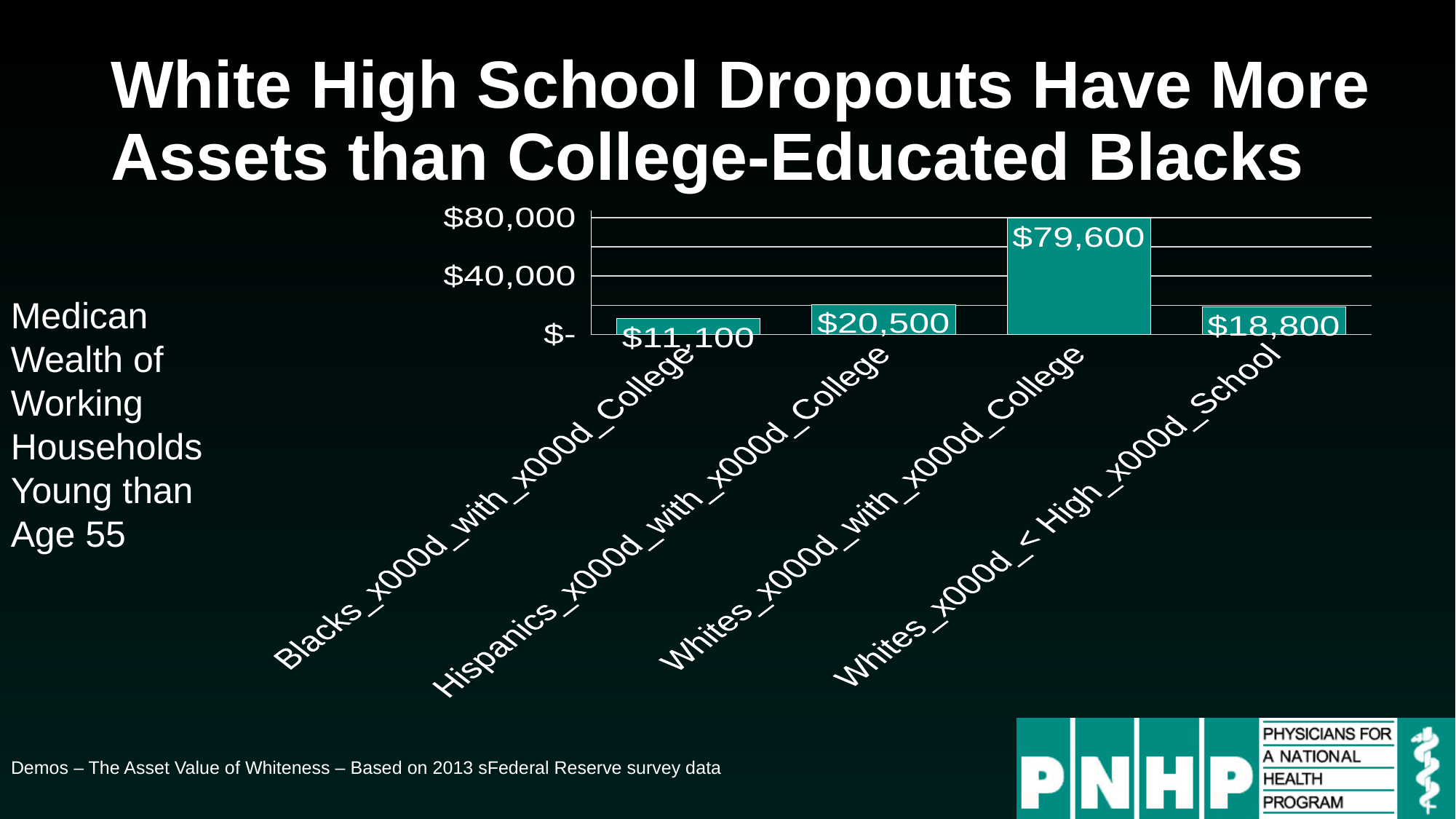
What is the difference between the median wealth of Whites with College and Blacks with College? $68,500 What is the median wealth value shown for Blacks with College? $11,100 What is the median wealth value shown for Whites with College? $79,600 How many categories are shown in the chart? 4 What is the difference between the median wealth of Hispanics with College and Whites with less than High School? $1,700 What kind of chart is shown on the slide? bar chart Is the value for Whites with College greater or less than $40,000? greater Which is larger, the median wealth of Whites with less than High School or Blacks with College? Whites with less than High School What is the median wealth value shown for Hispanics with College? $20,500 What is the median wealth value shown for Whites with less than High School? $18,800 Which category has the lowest median wealth? Blacks with College Which category has the highest median wealth? Whites with College